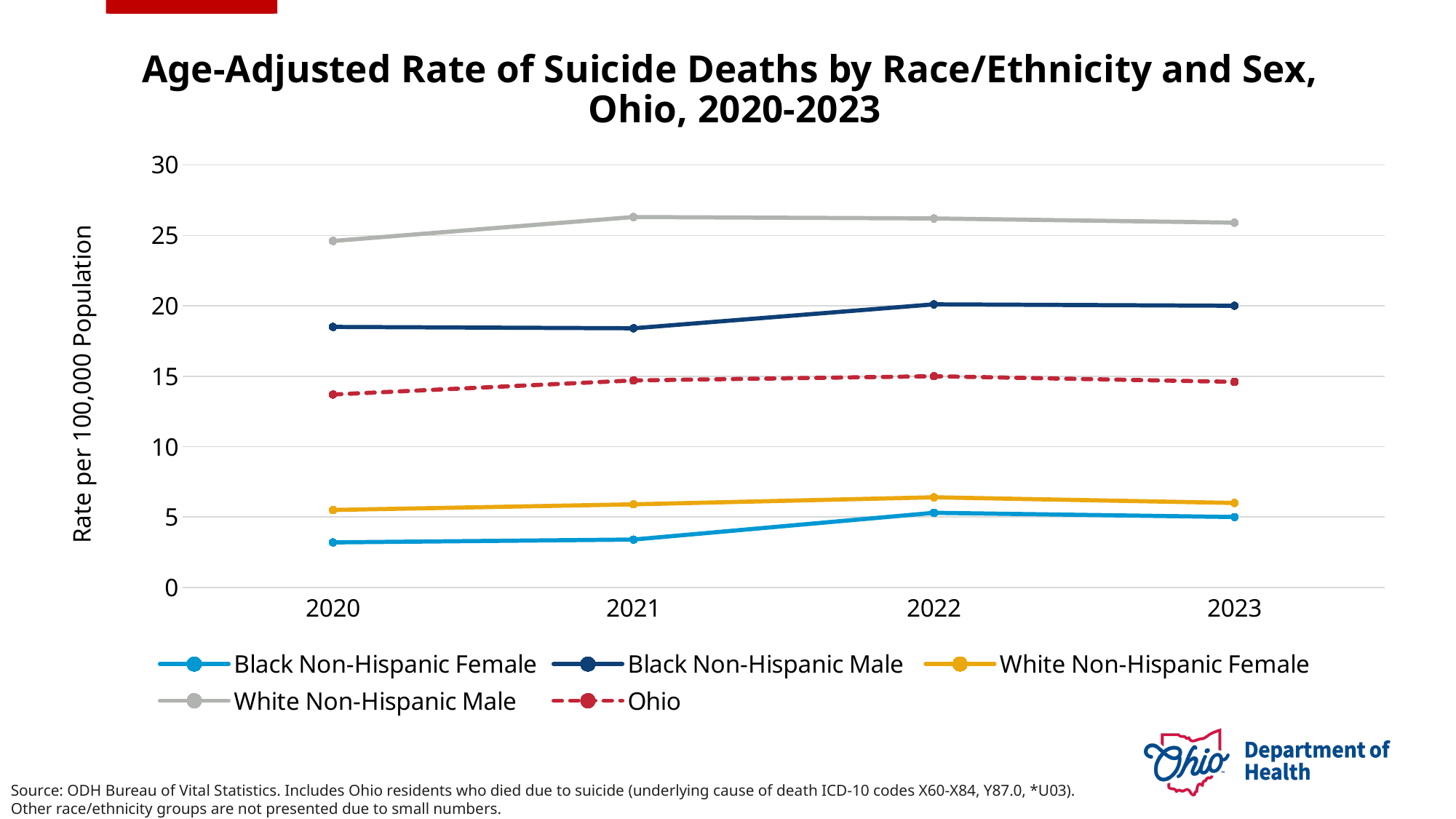
Which series has the highest rate in 2023? White Non-Hispanic Male Which series is drawn with a dashed line? Ohio Is the value for Black Non-Hispanic Female in 2020 greater or less than 5? less Does the Ohio rate rise or fall from 2020 to 2022? rise Is the value for White Non-Hispanic Male in 2021 greater or less than 25? greater What kind of chart is shown on the slide? line chart Is the value for Ohio in 2020 greater or less than 15? less How many years are shown on the x axis? 4 Which series has the lowest rate in 2020? Black Non-Hispanic Female In 2022, which is larger: the rate for Black Non-Hispanic Female or White Non-Hispanic Female? White Non-Hispanic Female How many series does the legend list? 5